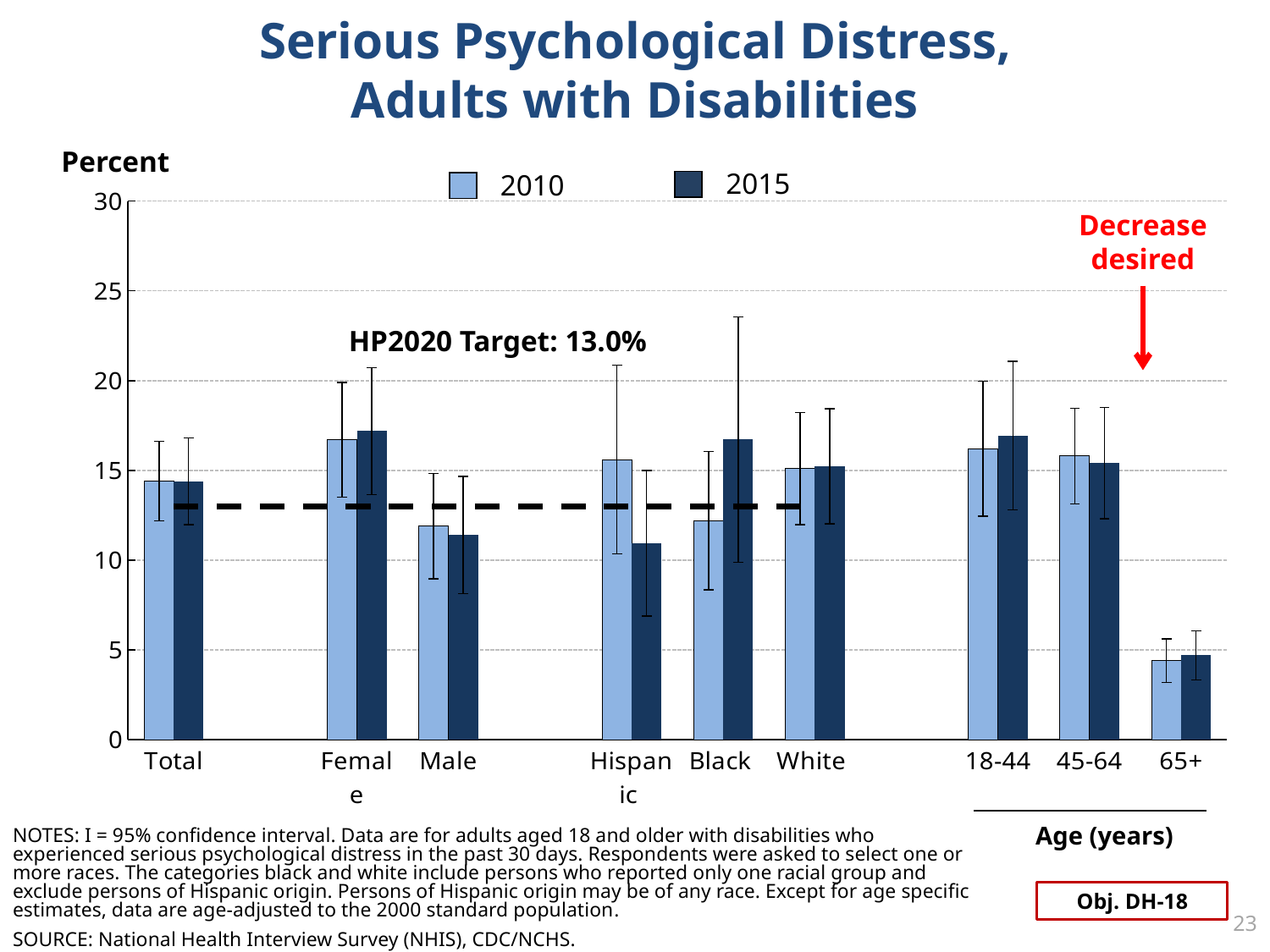
Which category has the lowest value for 2010? 65+ Is the 2010 value for 65+ greater or less than 5? less Is the 2015 value for Black greater or less than 15? greater Is the 2015 value for Male greater or less than 15? less What kind of chart is shown on the slide? bar chart What is the HP2020 Target value shown on the chart? 13.0% How many series does the legend list? 2 For Hispanic, which year has the larger value, 2010 or 2015? 2010 How many categories are shown along the x axis? 9 Which category has the lowest value for 2015? 65+ For Black, which year has the larger value, 2010 or 2015? 2015